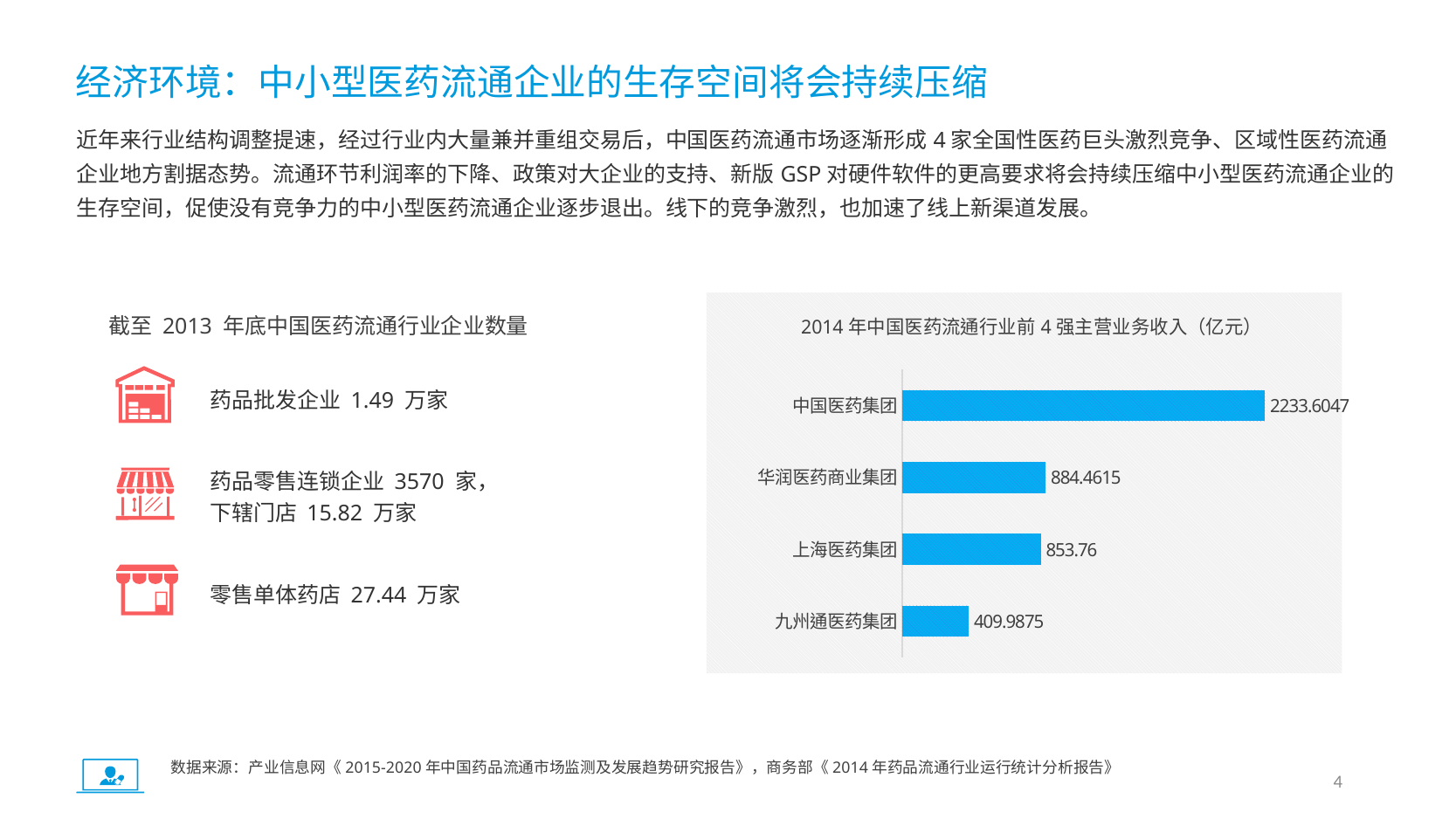
What kind of chart is used to show the 2014 revenue data? Bar chart Which company has the lowest main business revenue in the chart? 九州通医药集团 What is the value shown for 九州通医药集团? 409.9875 What is the main business revenue of 中国医药集团 in the chart? 2233.6047 What is the value shown for 上海医药集团? 853.76 What is the value shown for 华润医药商业集团? 884.4615 How many companies are shown in the chart? 4 Which company has the highest main business revenue in the chart? 中国医药集团 What unit is given in the chart title for the revenue values? 亿元 What is the difference between the values for 中国医药集团 and 九州通医药集团? 1823.6172 Which is larger, the value for 华润医药商业集团 or the value for 上海医药集团? 华润医药商业集团 What is the difference between the values for 华润医药商业集团 and 上海医药集团? 30.7015